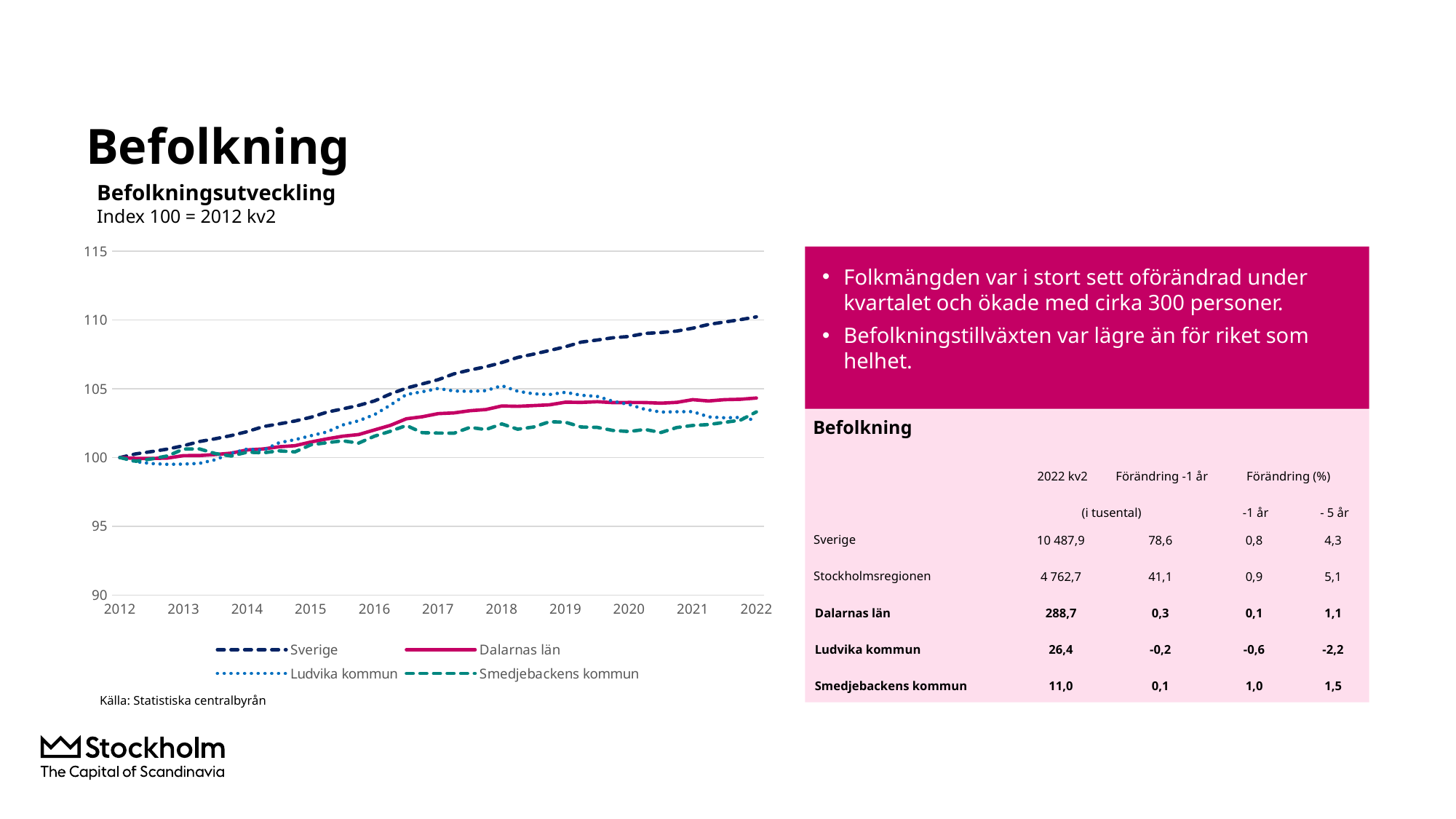
Which series has the lowest value in 2020? Smedjebackens kommun Which quarter is the index base (Index 100) for the chart? 2012 kv2 In 2022, which is larger: the value for Sverige or the value for Dalarnas län? Sverige Is the value for Ludvika kommun in 2022 greater or less than 105? less Is the value for Smedjebackens kommun in 2022 greater or less than 105? less How many years are labelled on the x axis of the chart? 11 What kind of chart is shown on the slide? line chart Is the value for Sverige in 2022 greater or less than 105? greater What is the title of the chart? Befolkningsutveckling Does the Sverige series rise or fall from 2012 to 2022? rise How many series does the chart legend list? 4 Which series has the highest value in 2022? Sverige